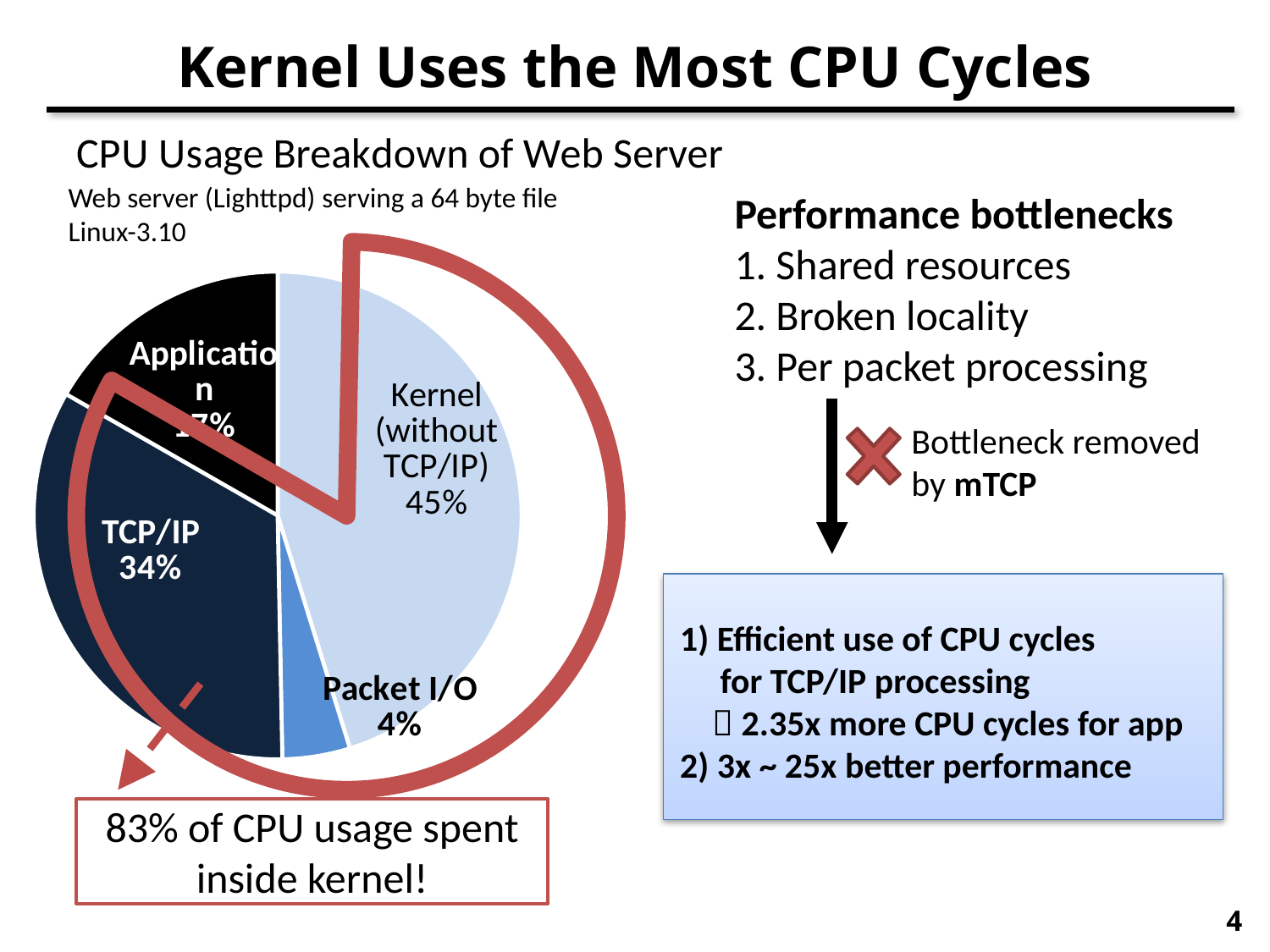
What percentage of CPU usage is attributed to TCP/IP in the pie chart? 34% What is the title of the chart on the slide? CPU Usage Breakdown of Web Server Which slice of the pie chart is the largest? Kernel (without TCP/IP) Which slice of the pie chart is the smallest? Packet I/O What type of chart is used to show the CPU usage breakdown? Pie chart What percentage of CPU usage does Packet I/O account for in the pie chart? 4% How many slices does the pie chart have? 4 Which is larger in the pie chart, TCP/IP or Packet I/O? TCP/IP Which Linux version is listed under the chart title? Linux-3.10 What is the combined percentage of the Kernel (without TCP/IP), TCP/IP and Packet I/O slices? 83% How many percentage points larger is the Kernel (without TCP/IP) slice than the TCP/IP slice? 11 percentage points What percentage of CPU usage does the Kernel (without TCP/IP) slice represent in the pie chart? 45%